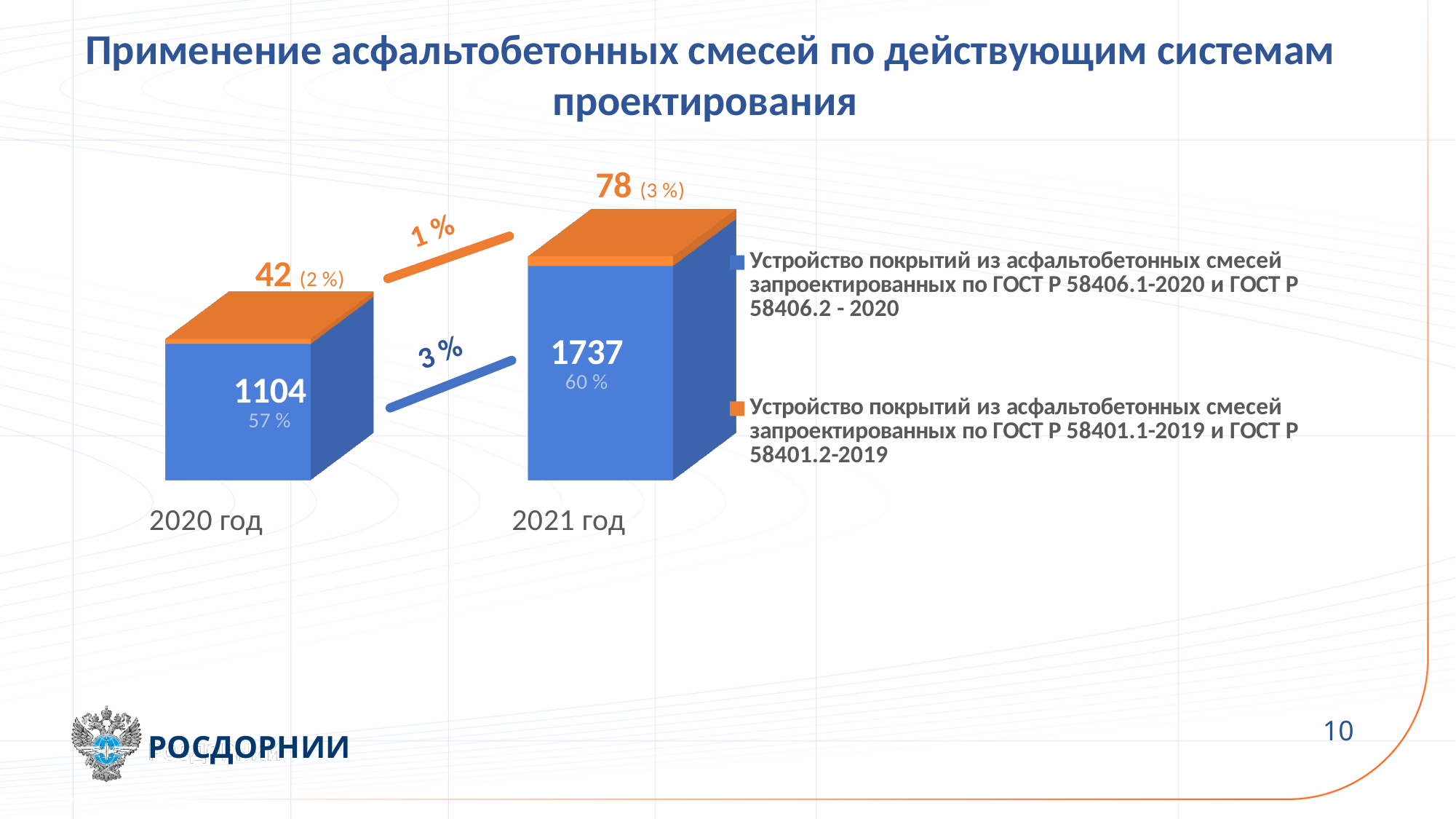
What is the value of the orange series (ГОСТ Р 58401.1-2019 и ГОСТ Р 58401.2-2019) for 2021 год? 78 Which year has the larger blue series value, 2020 год or 2021 год? 2021 год What kind of chart is shown on the slide? Stacked bar chart What is the value of the orange series (ГОСТ Р 58401.1-2019 и ГОСТ Р 58401.2-2019) for 2020 год? 42 What percentage share is shown next to the orange value for 2020 год? 2 % By how much did the orange series value increase from 2020 год to 2021 год? 36 What is the value of the blue series (ГОСТ Р 58406.1-2020 и ГОСТ Р 58406.2-2020) for 2020 год? 1104 What is the total of the stacked bar for 2021 год? 1815 How many series does the legend list? 2 What percentage share is shown next to the blue value for 2021 год? 60 % By how much did the blue series value increase from 2020 год to 2021 год? 633 What is the value of the blue series (ГОСТ Р 58406.1-2020 и ГОСТ Р 58406.2-2020) for 2021 год? 1737